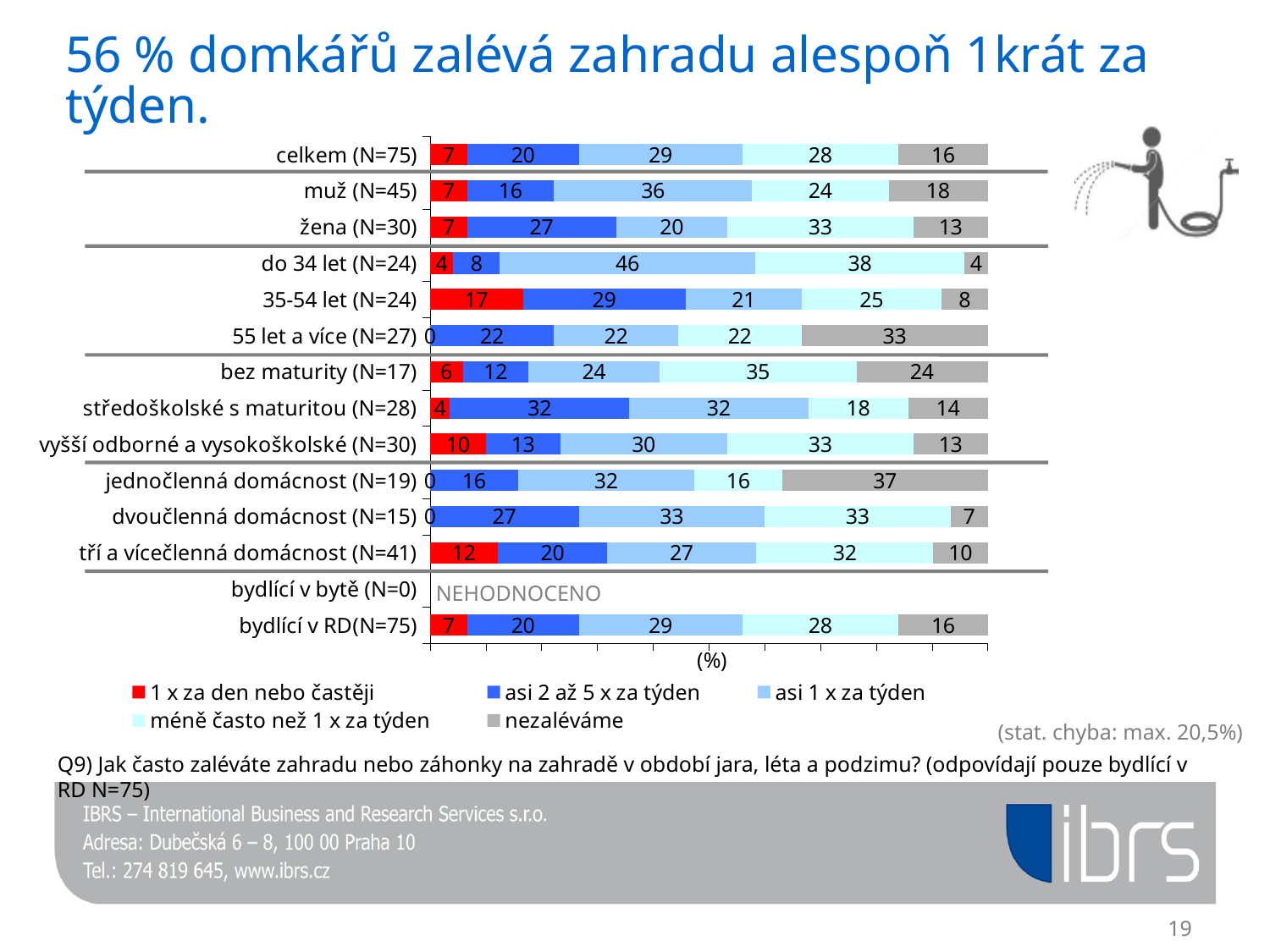
What is the value for "1 x za den nebo častěji" in the "vyšší odborné a vysokoškolské (N=30)" bar? 10 Which category has the highest value for "1 x za den nebo častěji"? 35-54 let (N=24) What kind of chart is shown on the slide? Stacked bar chart What is the value for "méně často než 1 x za týden" in the "celkem (N=75)" bar? 28 Which category has the highest value for "nezaléváme"? jednočlenná domácnost (N=19) What is the difference between the "asi 2 až 5 x za týden" values for "žena (N=30)" and "muž (N=45)"? 11 Which has the larger "nezaléváme" value: "55 let a více (N=27)" or "dvoučlenná domácnost (N=15)"? 55 let a více (N=27) What is the value for "asi 1 x za týden" in the "do 34 let (N=24)" bar? 46 How many series does the legend list? 5 Which has the larger "méně často než 1 x za týden" value: "bez maturity (N=17)" or "středoškolské s maturitou (N=28)"? bez maturity (N=17) Which category is marked "NEHODNOCENO" instead of a bar? bydlící v bytě (N=0) What is the value for "nezaléváme" in the "jednočlenná domácnost (N=19)" bar? 37